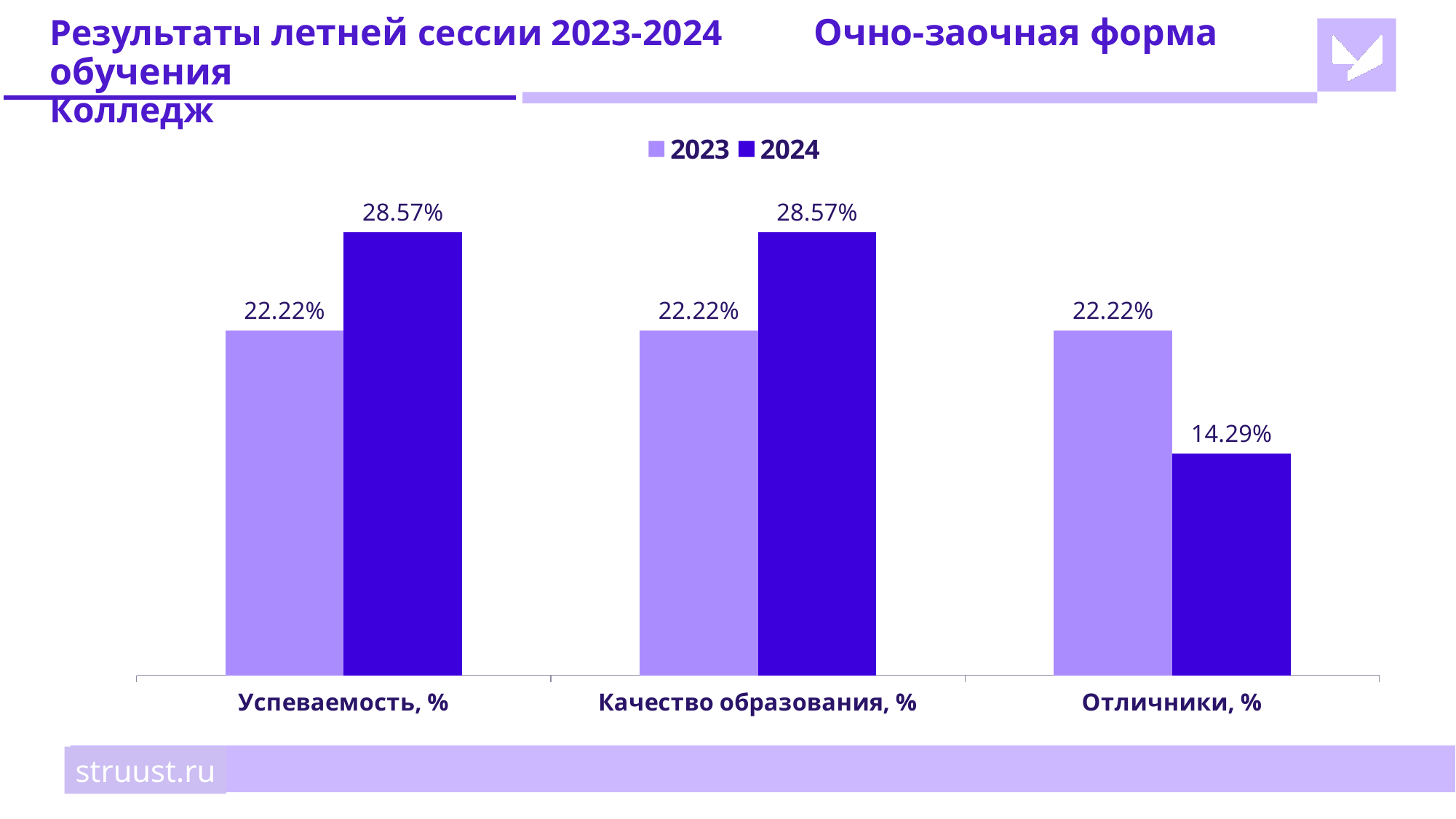
How many categories are shown on the x axis? 3 Which category has the lowest 2024 value? Отличники, % For Качество образования, %, which year has the larger value, 2023 or 2024? 2024 What is the difference between the 2024 and 2023 values for Успеваемость, %? 6.35% What is the difference between the 2023 and 2024 values for Отличники, %? 7.93% What is the 2023 value for Отличники, %? 22.22% What is the 2023 value for Качество образования, %? 22.22% What is the 2024 value for Успеваемость, %? 28.57% How many series does the legend list? 2 What kind of chart is shown on the slide? Bar chart For Отличники, %, which year has the larger value, 2023 or 2024? 2023 What is the 2024 value for Отличники, %? 14.29%